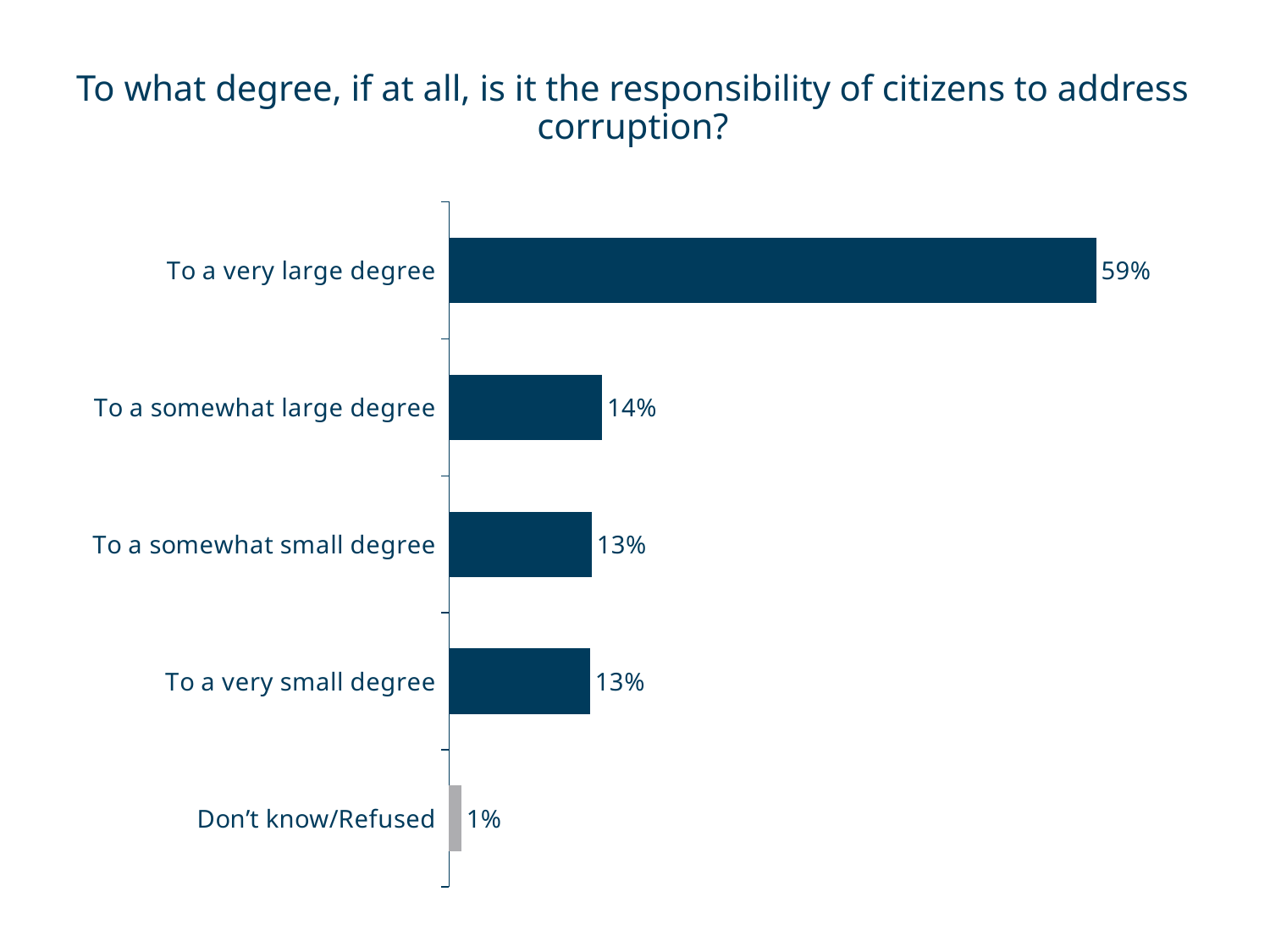
What type of chart is shown on the slide? Bar chart What percentage of respondents answered 'Don't know/Refused'? 1% What is the difference between 'To a somewhat large degree' and 'To a somewhat small degree'? 1 percentage point Which bar is shown in a different colour (grey) from the others? Don't know/Refused Which response category has the highest value? To a very large degree Which is larger: the value for 'To a very large degree' or the value for 'To a very small degree'? To a very large degree How many response categories are shown in the chart? 5 What is the value for 'To a very small degree'? 13% Which response category has the lowest value? Don't know/Refused What is the difference between 'To a very large degree' and 'To a somewhat large degree'? 45 percentage points What is the value for 'To a somewhat large degree'? 14% What percentage of respondents said citizens are responsible to a very large degree? 59%